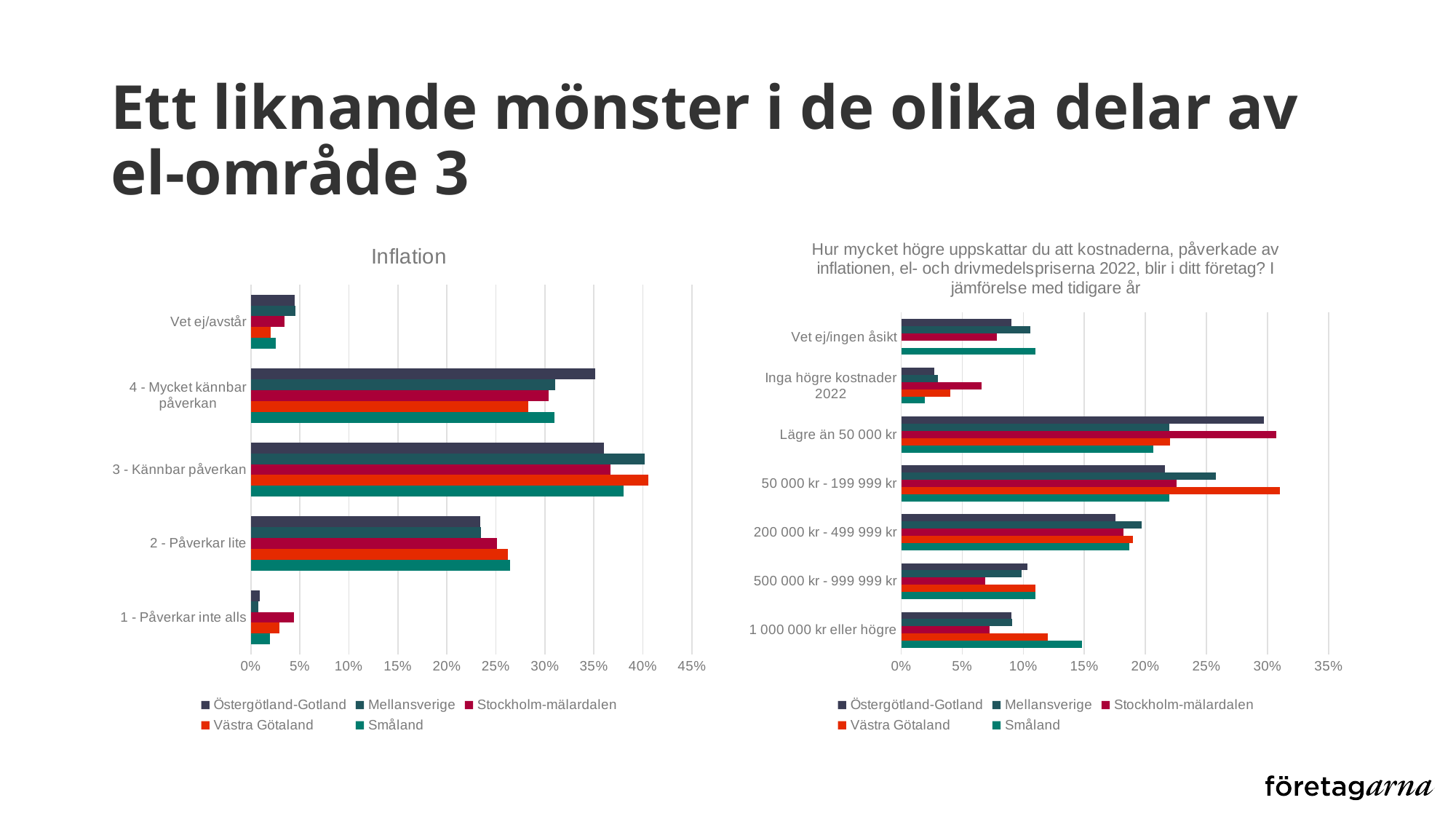
In the "Inflation" chart, for "1 - Påverkar inte alls", which is larger: Stockholm-mälardalen or Mellansverige? Stockholm-mälardalen How many categories are shown on the y axis of the right-hand chart ("Hur mycket högre uppskattar du att kostnaderna...")? 7 In the right-hand chart, which series has the highest value for "50 000 kr - 199 999 kr"? Västra Götaland In the "Inflation" chart, which category has the lowest value for Mellansverige? 1 - Påverkar inte alls What kind of chart is the chart titled "Inflation"? bar chart How many categories are shown on the y axis of the "Inflation" chart? 5 In the right-hand chart, is the value for Östergötland-Gotland in "Lägre än 50 000 kr" greater or less than 25%? greater In the "Inflation" chart, is the value for Västra Götaland in "3 - Kännbar påverkan" greater or less than 35%? greater How many series does the legend of the "Inflation" chart list? 5 In the "Inflation" chart, is the value for Östergötland-Gotland in "1 - Påverkar inte alls" greater or less than 5%? less In the "Inflation" chart, which category has the highest value for Västra Götaland? 3 - Kännbar påverkan